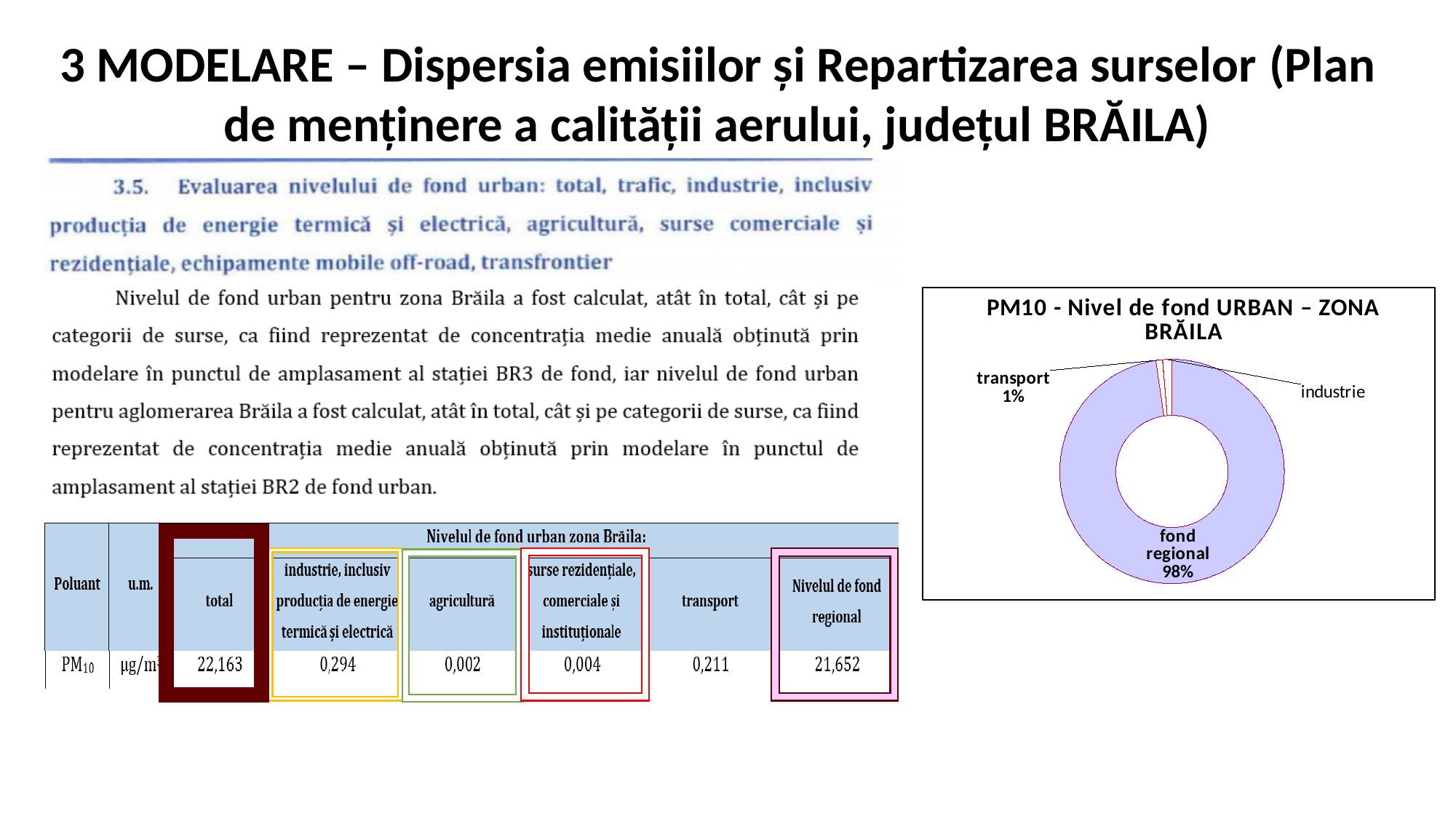
What is the title of the chart on the slide? PM10 - Nivel de fond URBAN – ZONA BRĂILA Which labelled category on the chart has no percentage value printed next to it? industrie What is the difference in percentage points between the 'fond regional' share and the 'transport' share? 97% What share of the chart does 'transport' account for? 1% Which is larger in the chart, the slice for 'fond regional' or the slice for 'transport'? fond regional Which pollutant does the chart refer to? PM10 What kind of chart is shown on the right of the slide? doughnut chart What share of the chart does 'fond regional' account for? 98% Which category has the largest slice in the chart? fond regional How many categories are labelled on the chart? 3